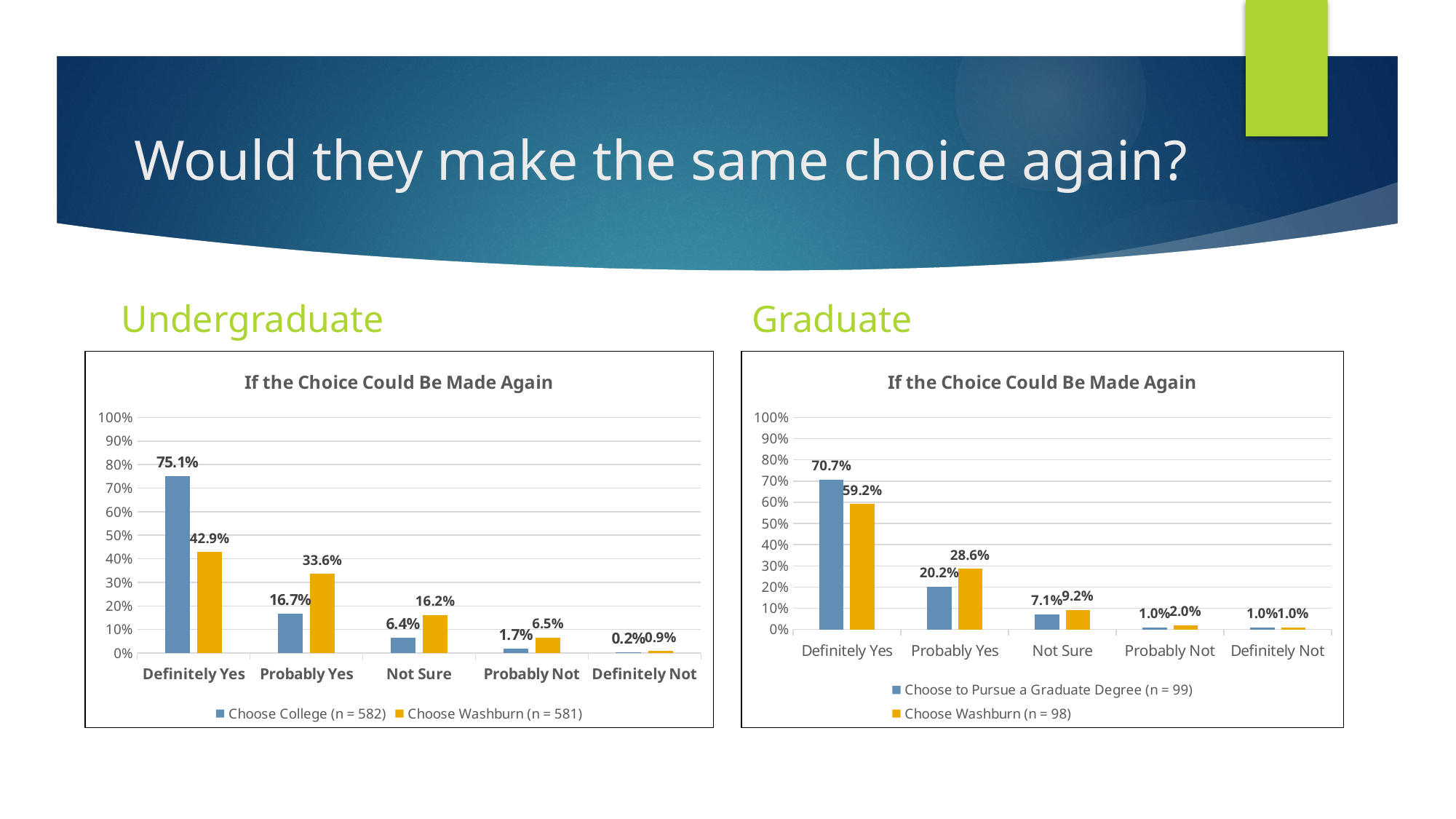
In the Graduate chart, what is the value for Choose to Pursue a Graduate Degree at Not Sure? 7.1% How many categories are shown on the x axis of the Graduate chart? 5 In the Graduate chart, which category has the highest value for Choose to Pursue a Graduate Degree? Definitely Yes In the Undergraduate chart, what is the difference between Choose College and Choose Washburn at Definitely Yes? 32.2% In the Undergraduate chart, which is larger at Not Sure: Choose College or Choose Washburn? Choose Washburn In the Undergraduate chart, what is the value for Choose Washburn at Probably Yes? 33.6% In the Undergraduate chart, which category has the lowest value for Choose Washburn? Definitely Not In the Graduate chart, what is the value for Choose Washburn at Definitely Yes? 59.2% In the Undergraduate chart, what is the value for Choose College at Definitely Yes? 75.1% What kind of chart is the Graduate chart? Bar chart How many series does the legend of the Undergraduate chart list? 2 In the Graduate chart, what is the difference between Choose Washburn and Choose to Pursue a Graduate Degree at Probably Yes? 8.4%